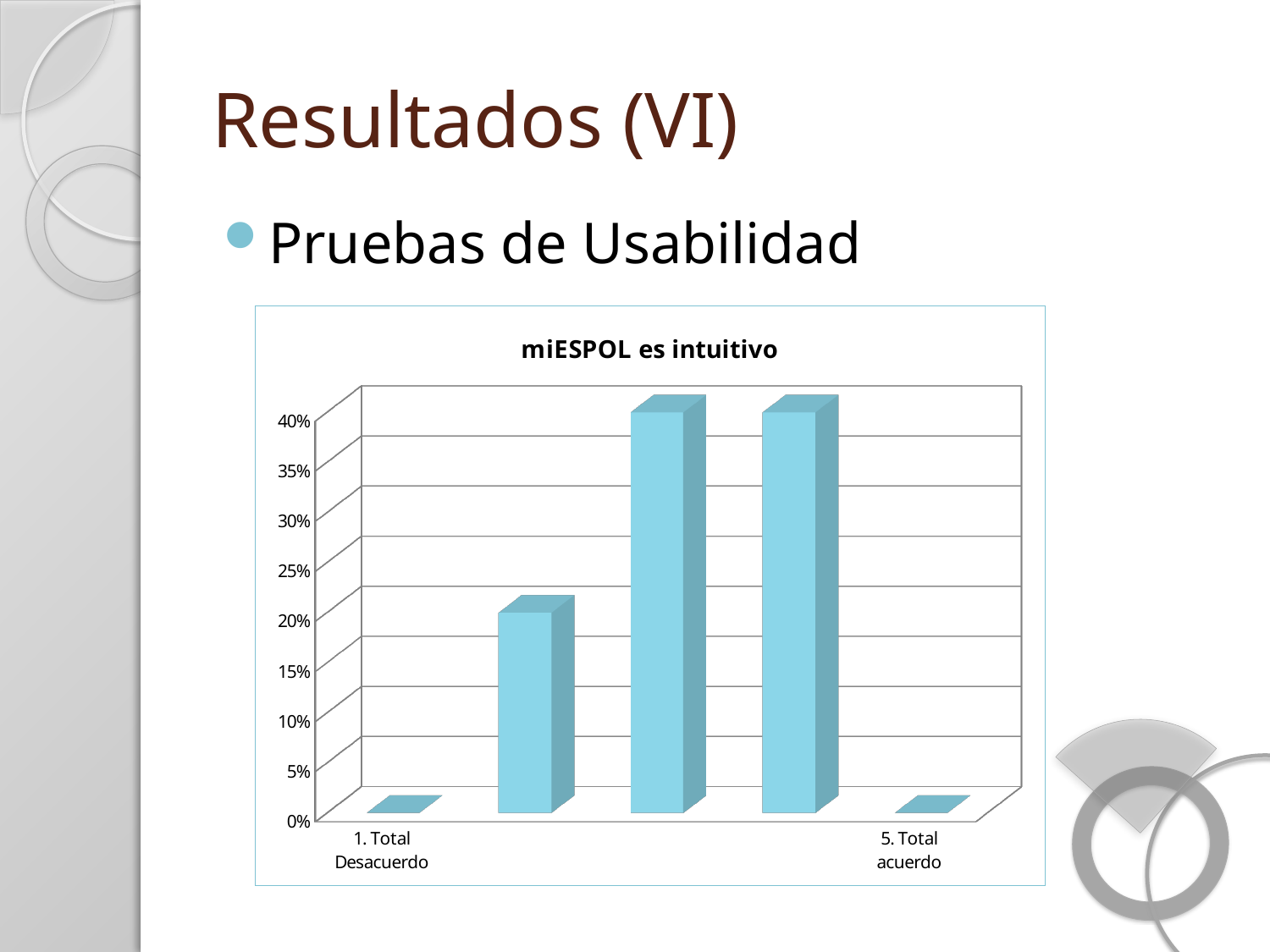
What is the title of the chart? miESPOL es intuitivo Is the value of the second bar from the left greater or less than 30%? less Is the value of the middle bar greater or less than 30%? greater What type of chart is shown on the slide? bar chart What is the value for "5. Total acuerdo"? 0% How many bars are plotted in the chart? 5 What is the highest value shown on the vertical axis? 40% Is the value of the fourth bar from the left greater or less than 25%? greater What is the value for "1. Total Desacuerdo"? 0%